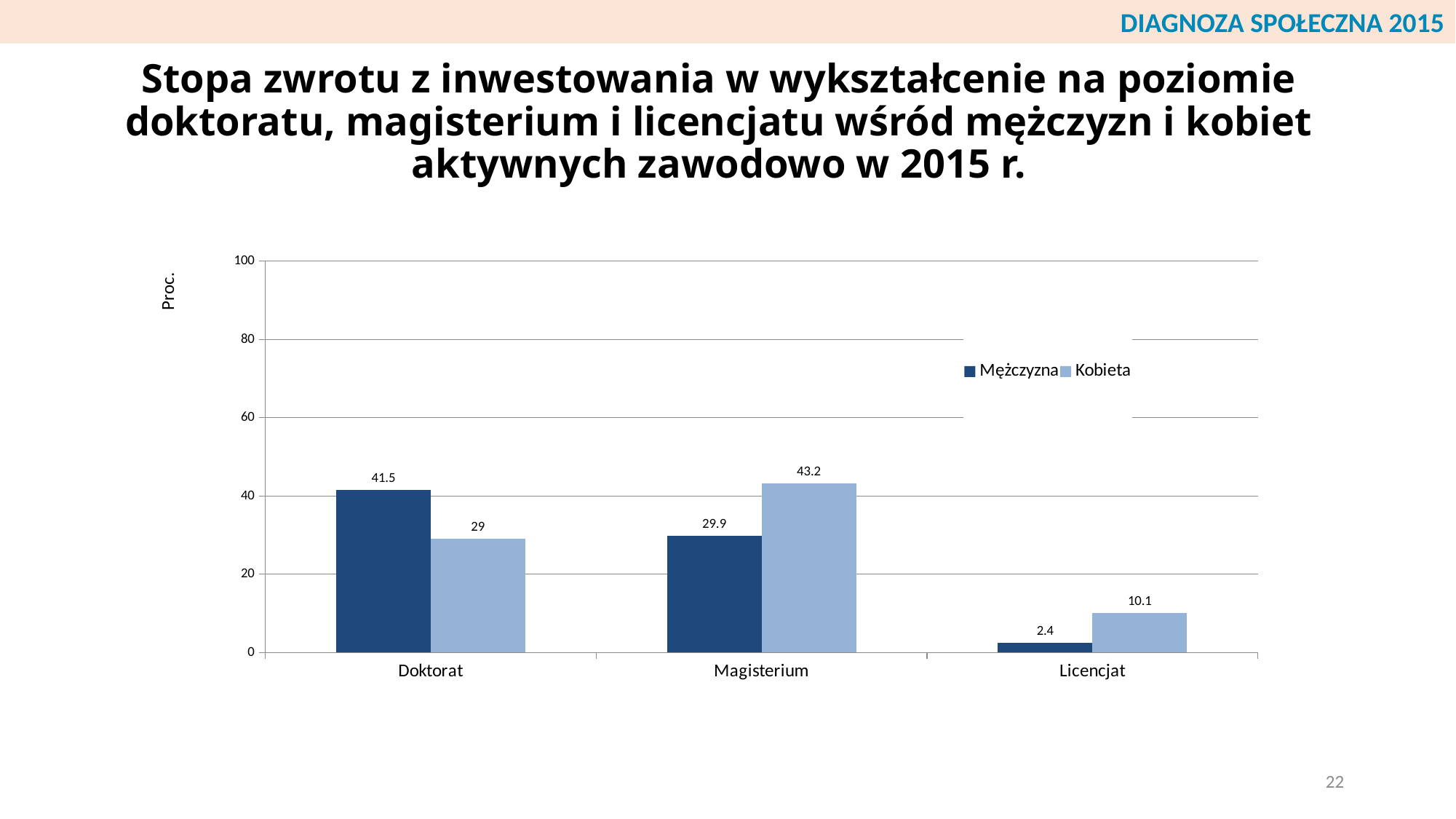
What is the difference between the Kobieta and Mężczyzna values in the Licencjat category? 7.7 What is the value for Kobieta in the Doktorat category? 29 What is the value for Mężczyzna in the Licencjat category? 2.4 How many categories are shown on the x axis? 3 How many series does the legend list? 2 Which is larger in the Magisterium category, the Mężczyzna value or the Kobieta value? Kobieta Which category has the highest value for the Kobieta series? Magisterium What kind of chart is shown on the slide? Bar chart What is the value for Mężczyzna in the Doktorat category? 41.5 What is the value for Kobieta in the Magisterium category? 43.2 What is the difference between the Mężczyzna and Kobieta values in the Doktorat category? 12.5 Which category has the lowest value for the Mężczyzna series? Licencjat